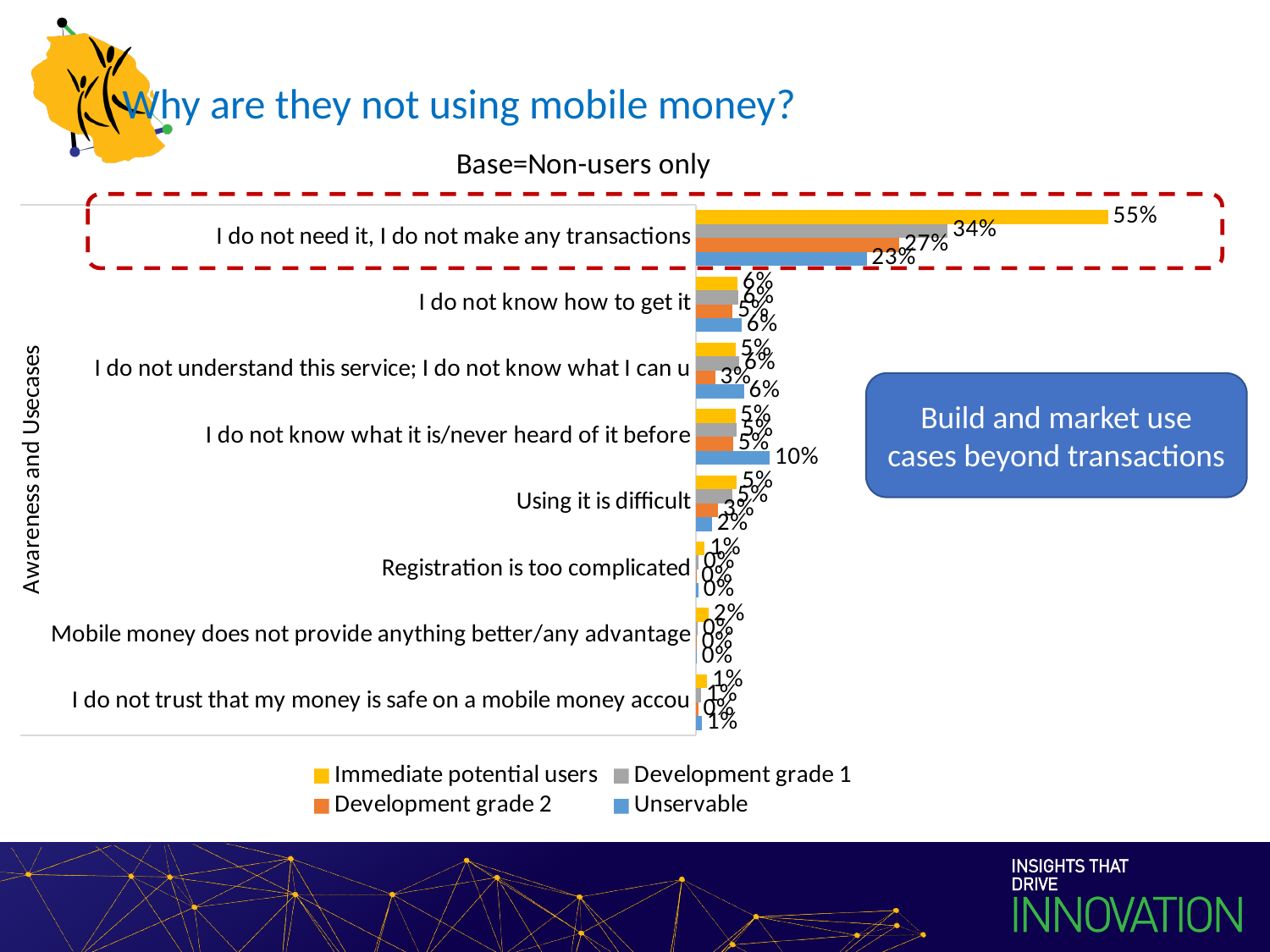
Which series is shown in yellow according to the legend? Immediate potential users Which category has the highest value for Immediate potential users? I do not need it, I do not make any transactions For "I do not need it, I do not make any transactions", which series has the larger value: Development grade 1 or Unservable? Development grade 1 What is the value for Immediate potential users for "I do not need it, I do not make any transactions"? 55% How many categories (reasons) are shown on the chart? 8 What is the value for Unservable for "I do not know what it is/never heard of it before"? 10% How many series does the legend list? 4 What is the difference between the Immediate potential users value and the Unservable value for "I do not need it, I do not make any transactions"? 32 percentage points What is the value for Development grade 1 for "I do not need it, I do not make any transactions"? 34% What is the value for Unservable for "I do not need it, I do not make any transactions"? 23% What is the value for Development grade 2 for "I do not need it, I do not make any transactions"? 27% What kind of chart is shown on the slide? Bar chart